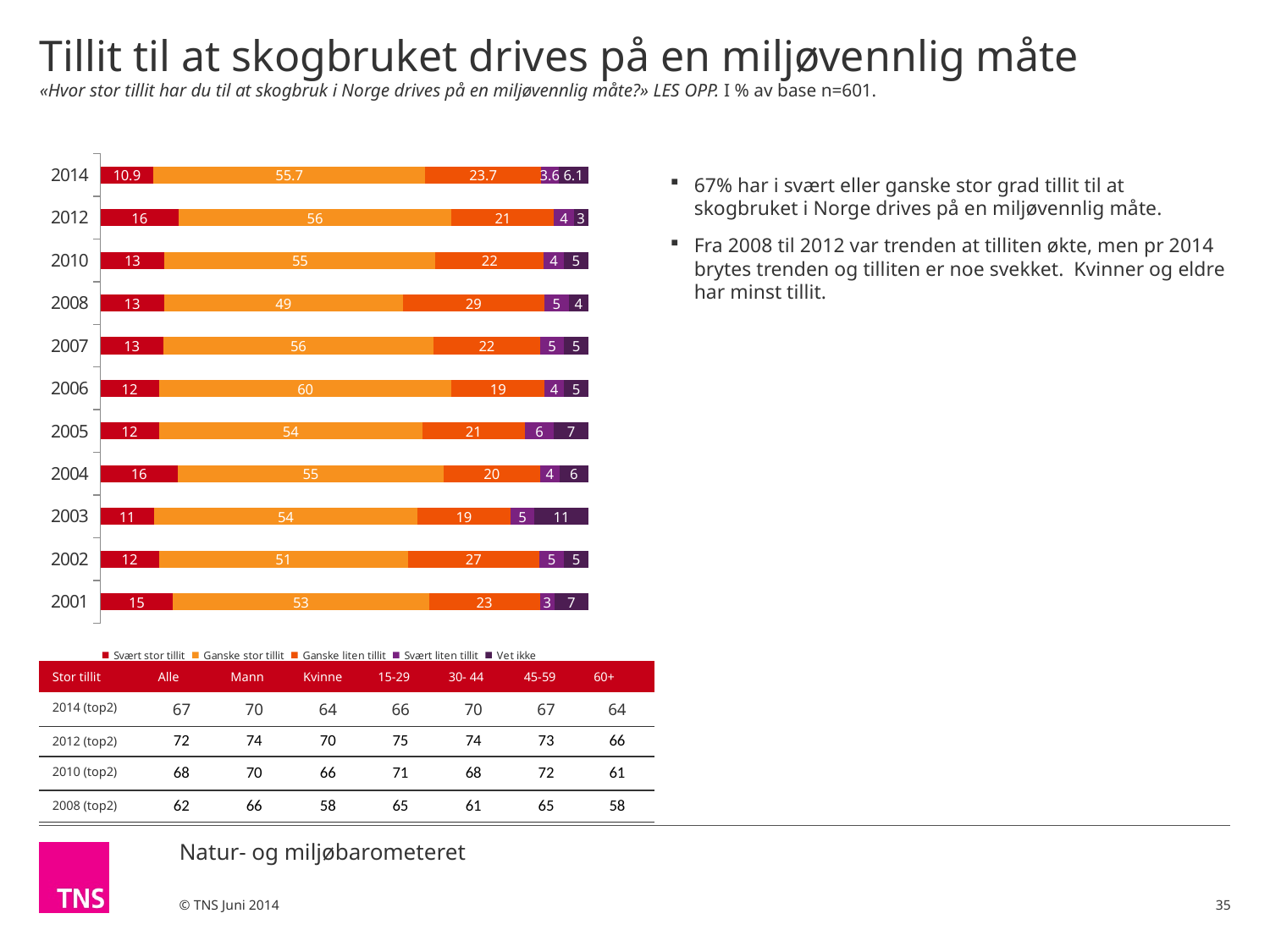
How many years are shown on the chart? 11 How many series does the legend list? 5 In which year is the value for Ganske stor tillit lowest? 2008 What is the value for Ganske stor tillit in 2014? 55.7 What is the difference between the Ganske liten tillit values for 2008 and 2006? 10 Which is larger, the Svært stor tillit value for 2004 or for 2003? 2004 What is the value for Svært stor tillit in 2012? 16 What is the total of the stacked bar for 2012? 100 What kind of chart is shown on the slide? stacked bar chart What is the value for Ganske liten tillit in 2008? 29 What is the value for Vet ikke in 2003? 11 In which year is the value for Ganske stor tillit highest? 2006